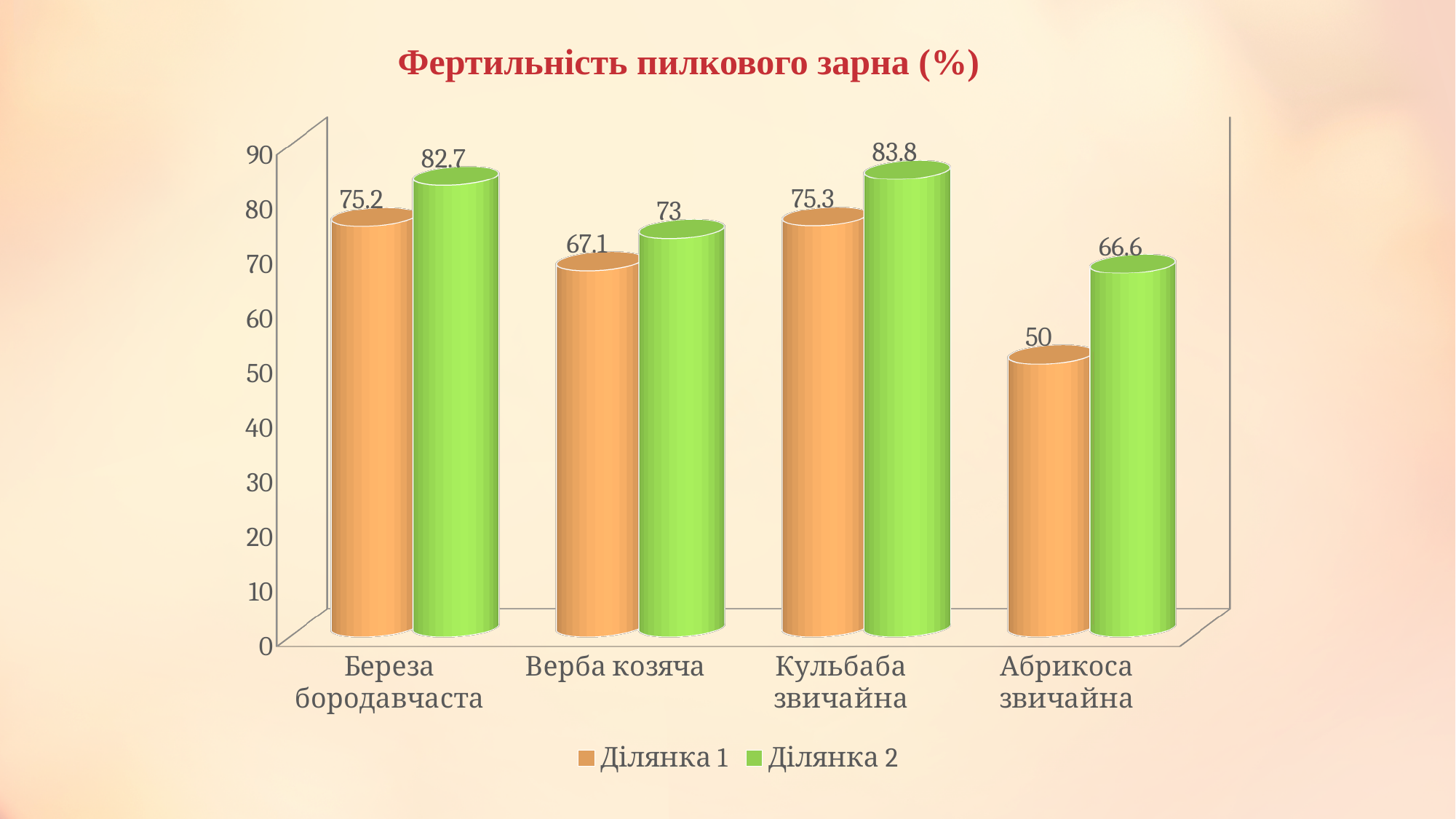
Which category has the highest value for Ділянка 2? Кульбаба звичайна What kind of chart is shown on the slide? bar chart What is the value for Ділянка 1 for Береза бородавчаста? 75.2 How many categories are shown on the x axis? 4 Which is larger for Верба козяча: Ділянка 1 or Ділянка 2? Ділянка 2 Is the value for Ділянка 2 for Береза бородавчаста greater or less than 80? greater What is the value for Ділянка 2 for Кульбаба звичайна? 83.8 What is the difference between Ділянка 2 and Ділянка 1 for Абрикоса звичайна? 16.6 What is the value for Ділянка 1 for Абрикоса звичайна? 50 How many series does the legend list? 2 What is the title of the chart? Фертильність пилкового зарна (%) Which category has the lowest value for Ділянка 1? Абрикоса звичайна